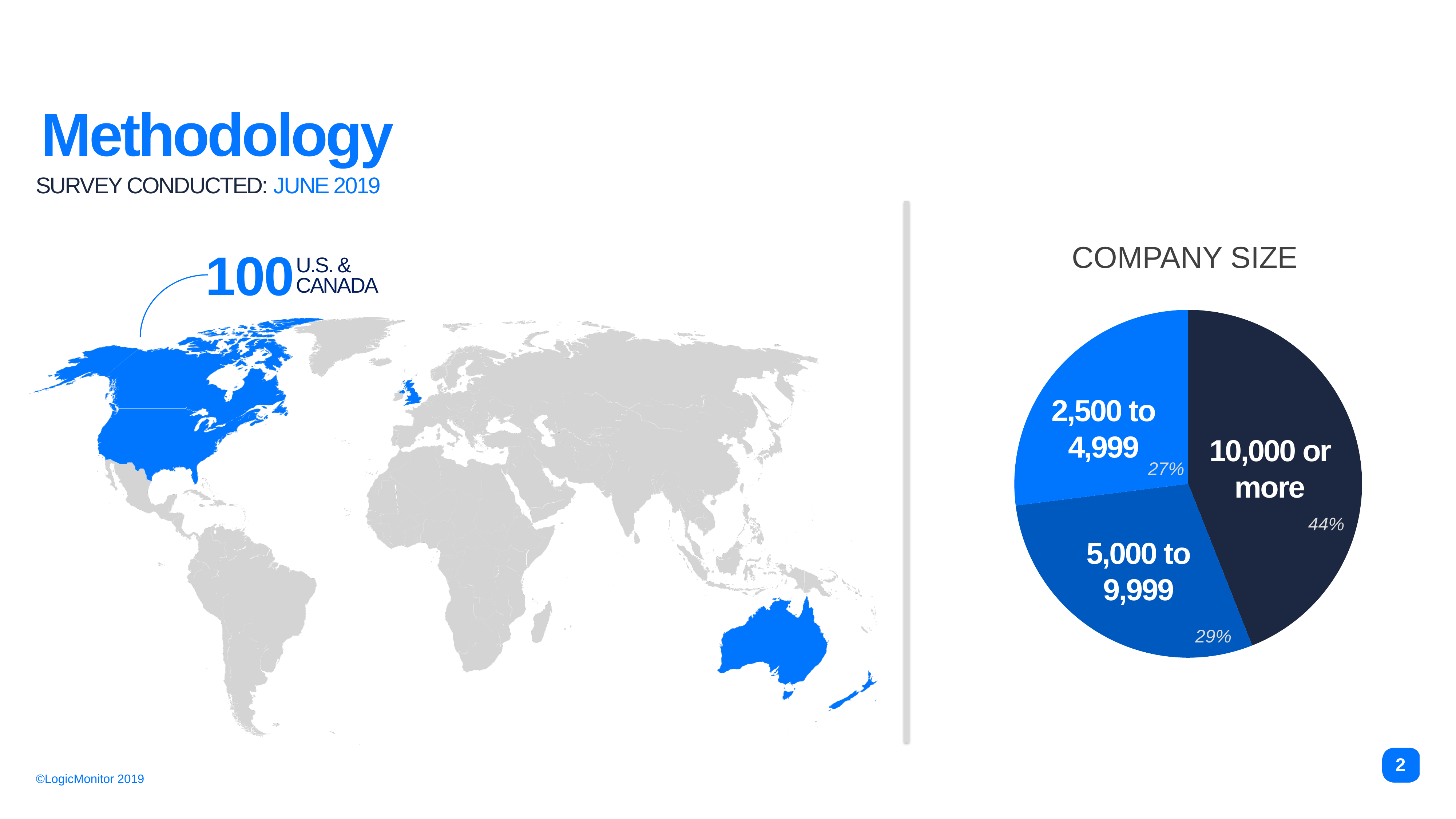
Which company size category has the smallest slice in the Company Size pie chart? 2,500 to 4,999 In the Company Size pie chart, what is the difference in percentage points between the 10,000 or more slice and the 5,000 to 9,999 slice? 15 In the Company Size pie chart, what share of companies have 10,000 or more employees? 44% What is the title of the pie chart on the slide? COMPANY SIZE Which company size category has the largest slice in the Company Size pie chart? 10,000 or more In the Company Size pie chart, what share of companies are in the 2,500 to 4,999 category? 27% In the Company Size pie chart, what share of companies are in the 5,000 to 9,999 category? 29% In the Company Size pie chart, which is larger: the 10,000 or more slice or the 2,500 to 4,999 slice? 10,000 or more In the Company Size pie chart, what is the difference in percentage points between the 5,000 to 9,999 slice and the 2,500 to 4,999 slice? 2 In the Company Size pie chart, what colour is the 10,000 or more slice? dark navy What kind of chart is the Company Size chart? pie chart How many categories does the Company Size pie chart show? 3